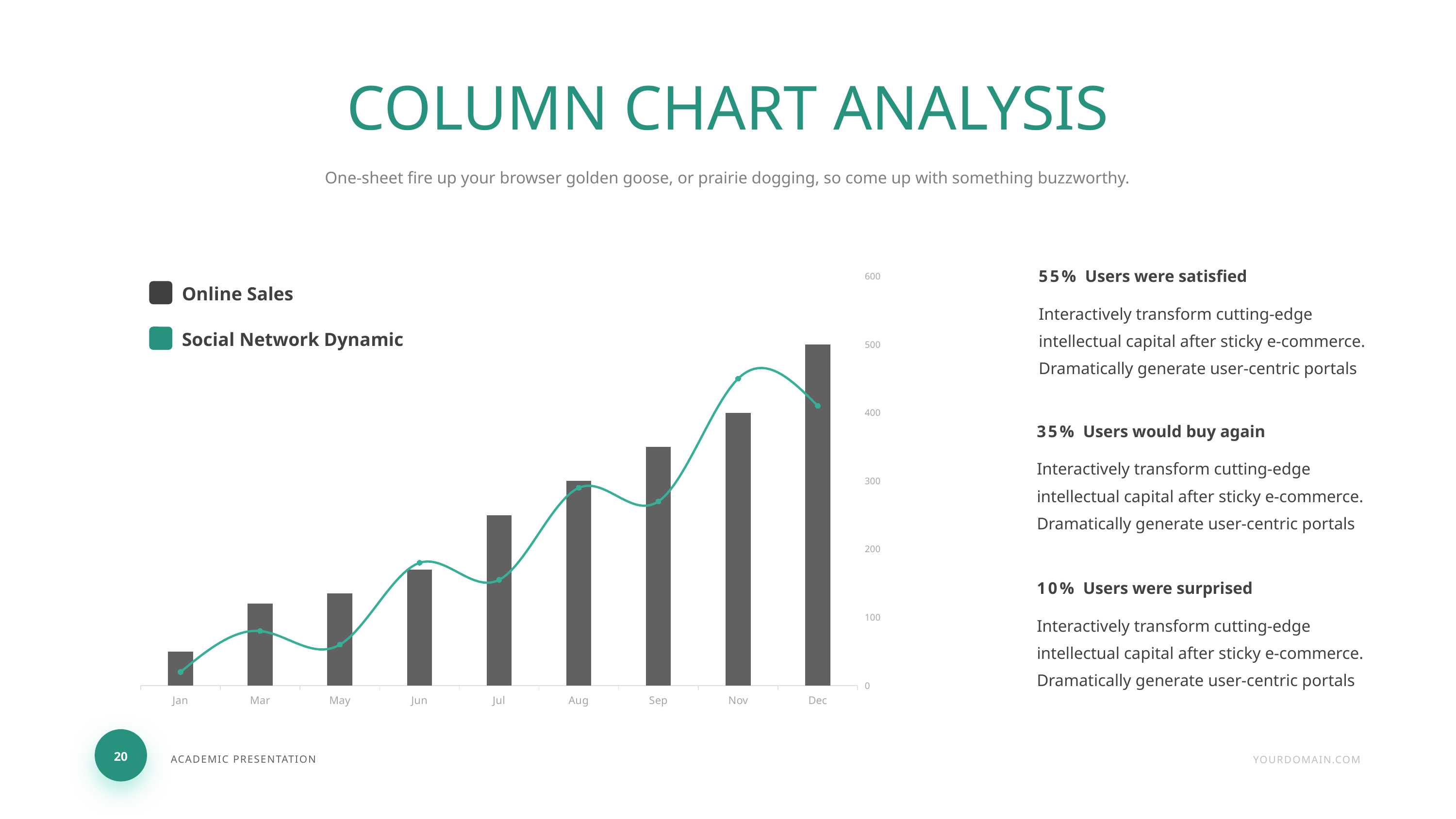
Is the Online Sales value for Jul greater or less than 200? greater Is the Online Sales value for Jan greater or less than 100? less How many months are shown on the x axis? 9 Which month has the lowest Online Sales value? Jan What colour is used for the Social Network Dynamic series in the legend? Green How many series does the legend list? 2 Which month has the highest Online Sales value? Dec Is the Social Network Dynamic value for Nov greater or less than 400? greater What kind of chart is used to plot the Online Sales series? Bar chart Which month has the highest Social Network Dynamic value? Nov Do the Online Sales values generally rise or fall from Jan to Dec? Rise In Dec, which series has the larger value, Online Sales or Social Network Dynamic? Online Sales